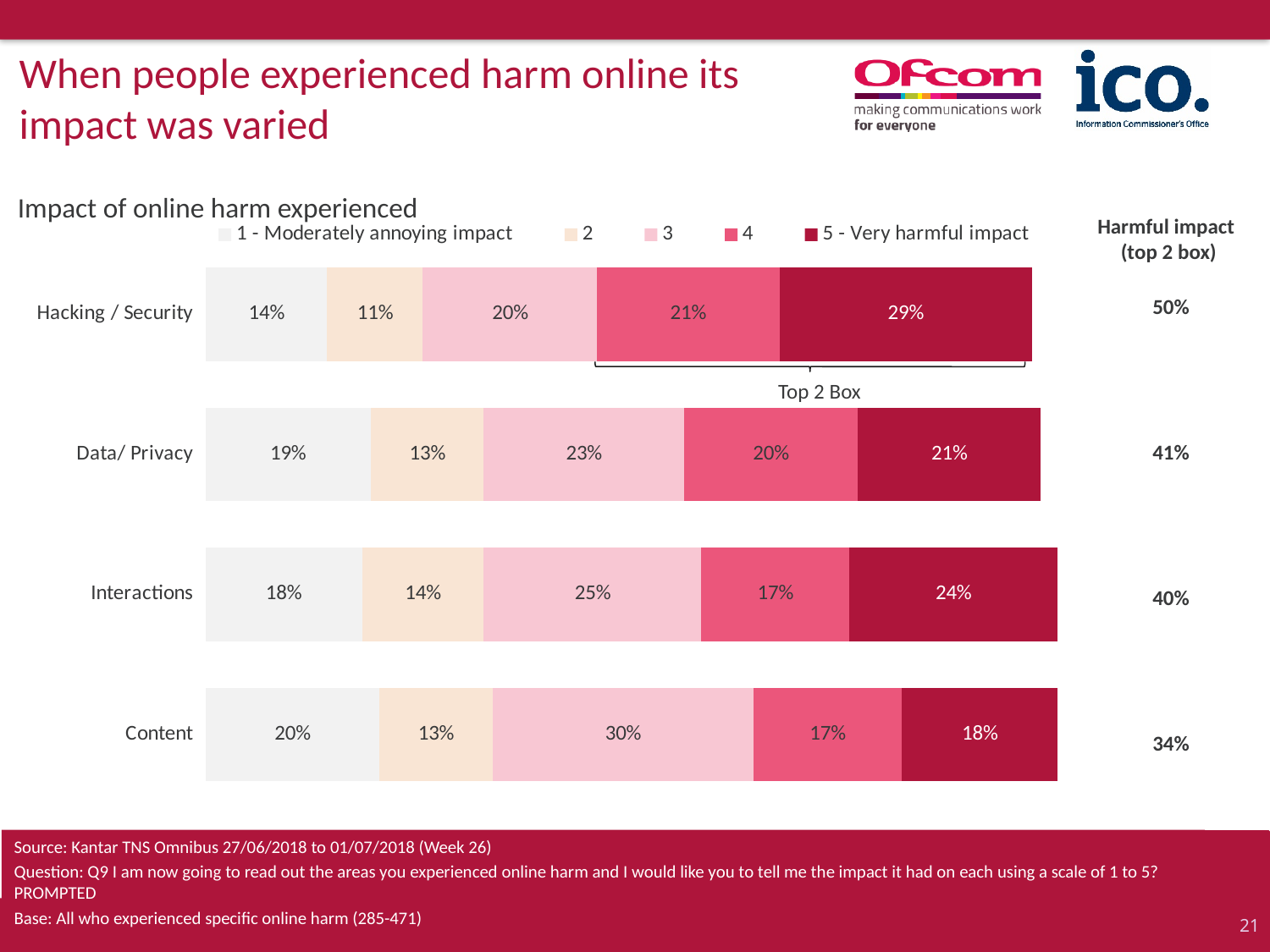
What percentage of the Data/ Privacy bar is '1 - Moderately annoying impact'? 19% What is the 'Harmful impact (top 2 box)' figure shown for Data/ Privacy? 41% What percentage of respondents rated the impact of Hacking / Security as '5 - Very harmful impact'? 29% Which is larger: the '3' rating share for Interactions or for Data/ Privacy? Interactions What is the title of the chart? Impact of online harm experienced Which category has the highest '5 - Very harmful impact' share? Hacking / Security What is the value for the '3' rating in the Content bar? 30% What kind of chart is shown on the slide? Stacked bar chart How many series does the legend list? 5 Which category has the lowest 'Harmful impact (top 2 box)' figure? Content What is the difference between the '5 - Very harmful impact' share for Hacking / Security and for Content? 11 percentage points How many harm categories are shown in the chart? 4